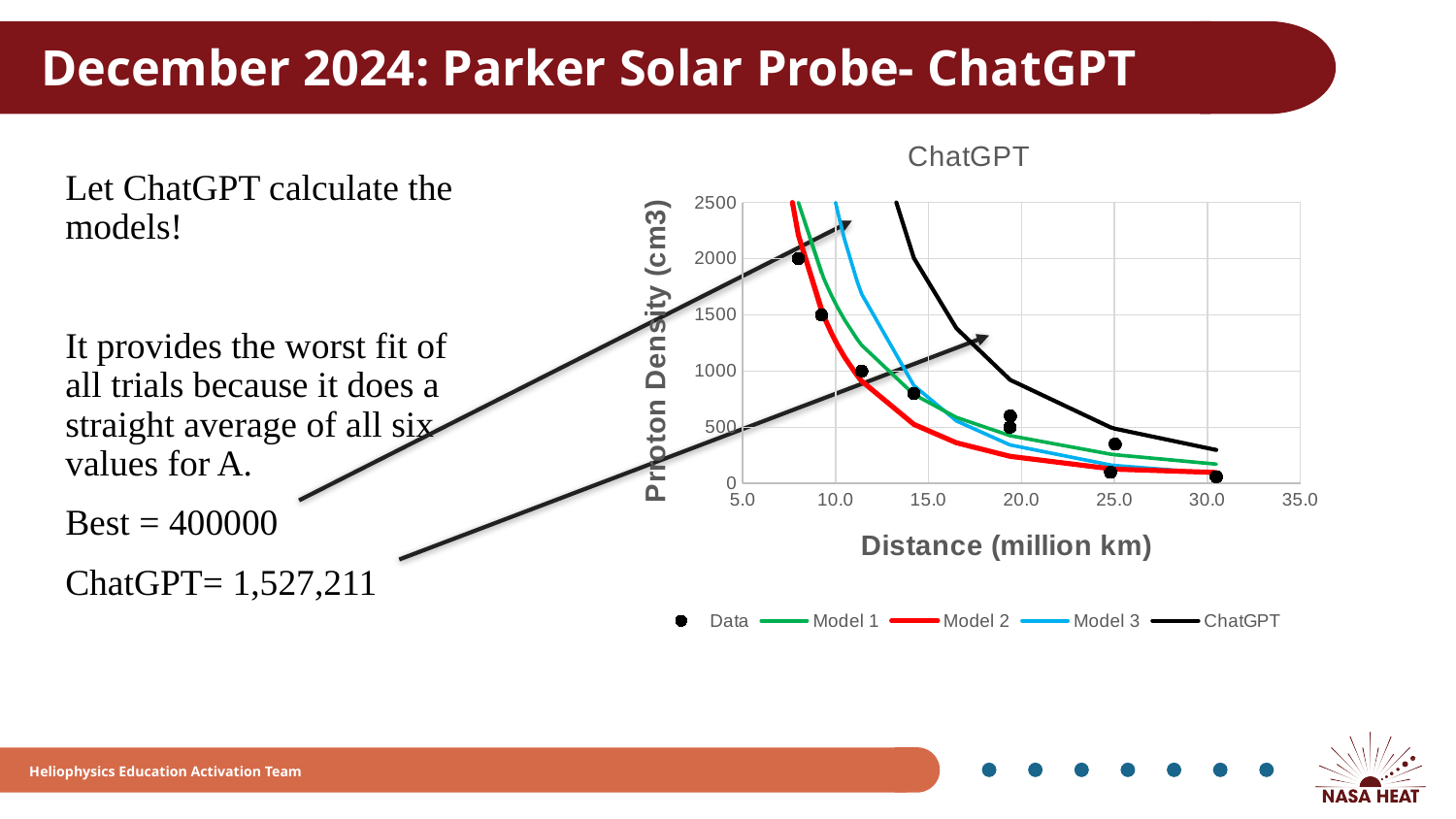
Is the ChatGPT line at a distance of 30 million km greater or less than 500? less Which series has the highest value at a distance of 25 million km? ChatGPT Which series has the lowest value at a distance of 15 million km? Model 2 Do the plotted values rise or fall as distance increases along the x axis? fall Is the Model 2 line at a distance of 20 million km greater or less than 500? less Is the Data point at a distance of about 8 million km greater or less than 1500 on the y axis? greater What is the label of the x axis of the chart? Distance (million km) What kind of chart is shown on the slide? line chart How many series does the chart legend list? 5 What is the title of the chart? ChatGPT At a distance of 20 million km, which is higher: the ChatGPT line or the Model 2 line? ChatGPT